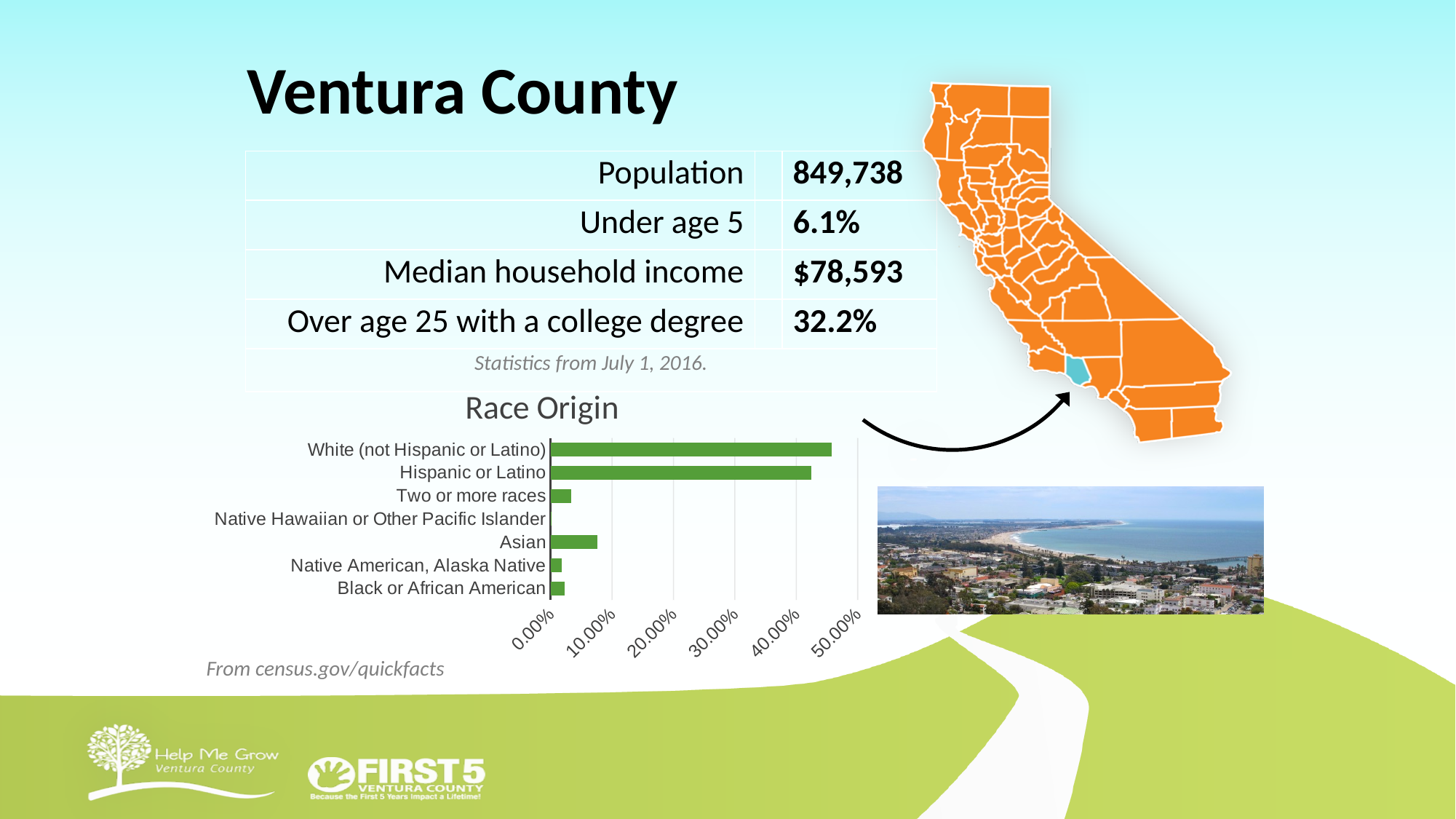
What colour are the bars in the Race Origin chart? green In the Race Origin chart, is the value for Two or more races greater or less than 10.00%? less What is the title of the bar chart on the slide? Race Origin In the Race Origin chart, which is larger: White (not Hispanic or Latino) or Hispanic or Latino? White (not Hispanic or Latino) In the Race Origin chart, which is larger: Asian or Two or more races? Asian Which category has the highest value in the Race Origin chart? White (not Hispanic or Latino) How many race origin categories are shown in the Race Origin chart? 7 In the Race Origin chart, is the value for Asian greater or less than 10.00%? less In the Race Origin chart, is the value for Hispanic or Latino greater or less than 40.00%? greater Which category has the lowest value in the Race Origin chart? Native Hawaiian or Other Pacific Islander What kind of chart is the Race Origin chart? bar chart